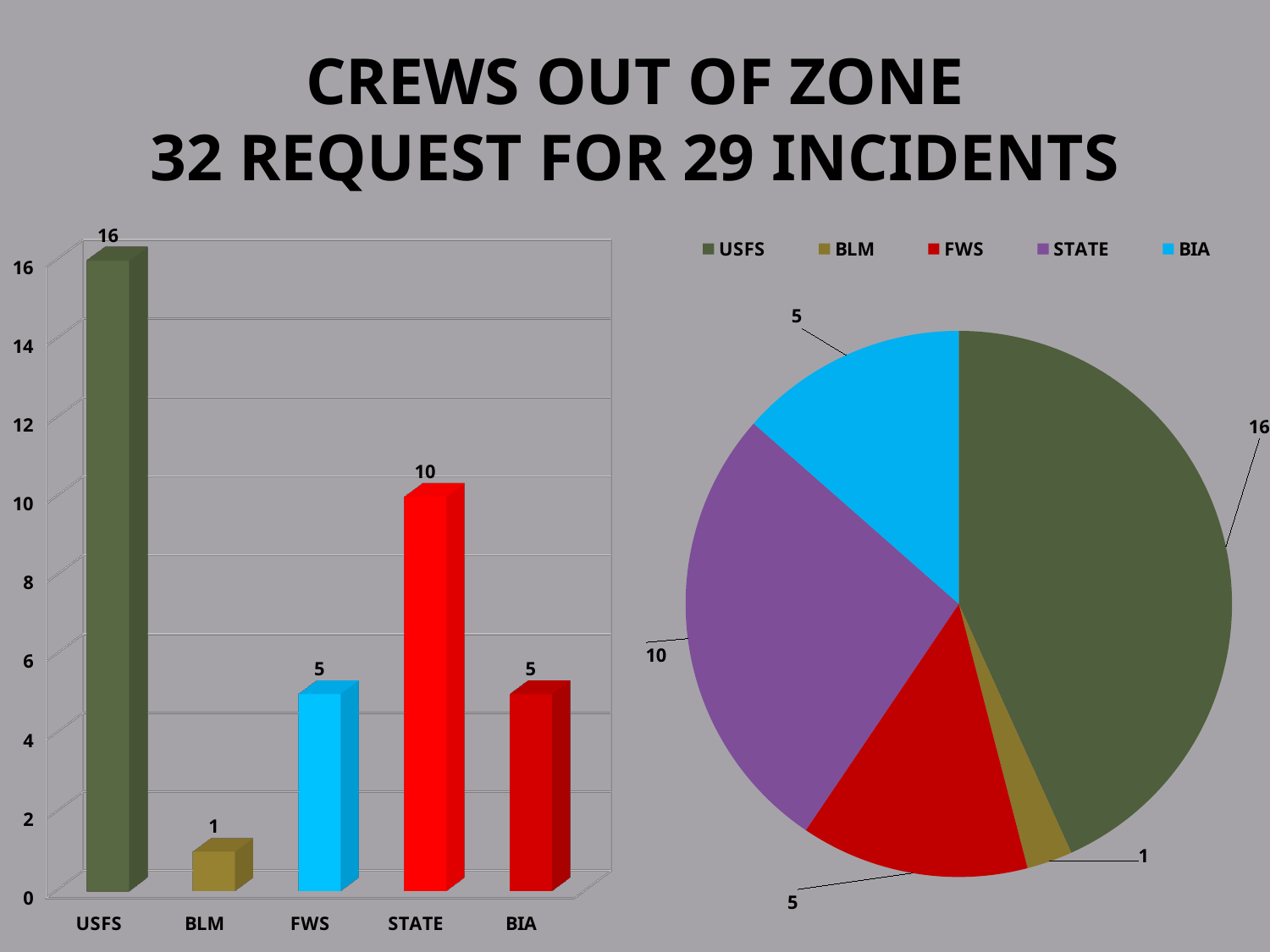
How many categories are shown in the bar chart on the left? 5 What kind of chart is on the left side of the slide? Bar chart What kind of chart is on the right side of the slide? Pie chart In the bar chart on the left, what is the value for USFS? 16 How many entries does the legend of the pie chart on the right list? 5 In the bar chart on the left, what is the value for BLM? 1 In the bar chart on the left, which category has the lowest value? BLM In the bar chart on the left, what is the difference between the values for USFS and STATE? 6 In the bar chart on the left, which is larger, the value for STATE or the value for BIA? STATE In the pie chart on the right, what is the value labelled for the STATE slice? 10 In the bar chart on the left, what is the value for STATE? 10 In the bar chart on the left, which category has the highest value? USFS